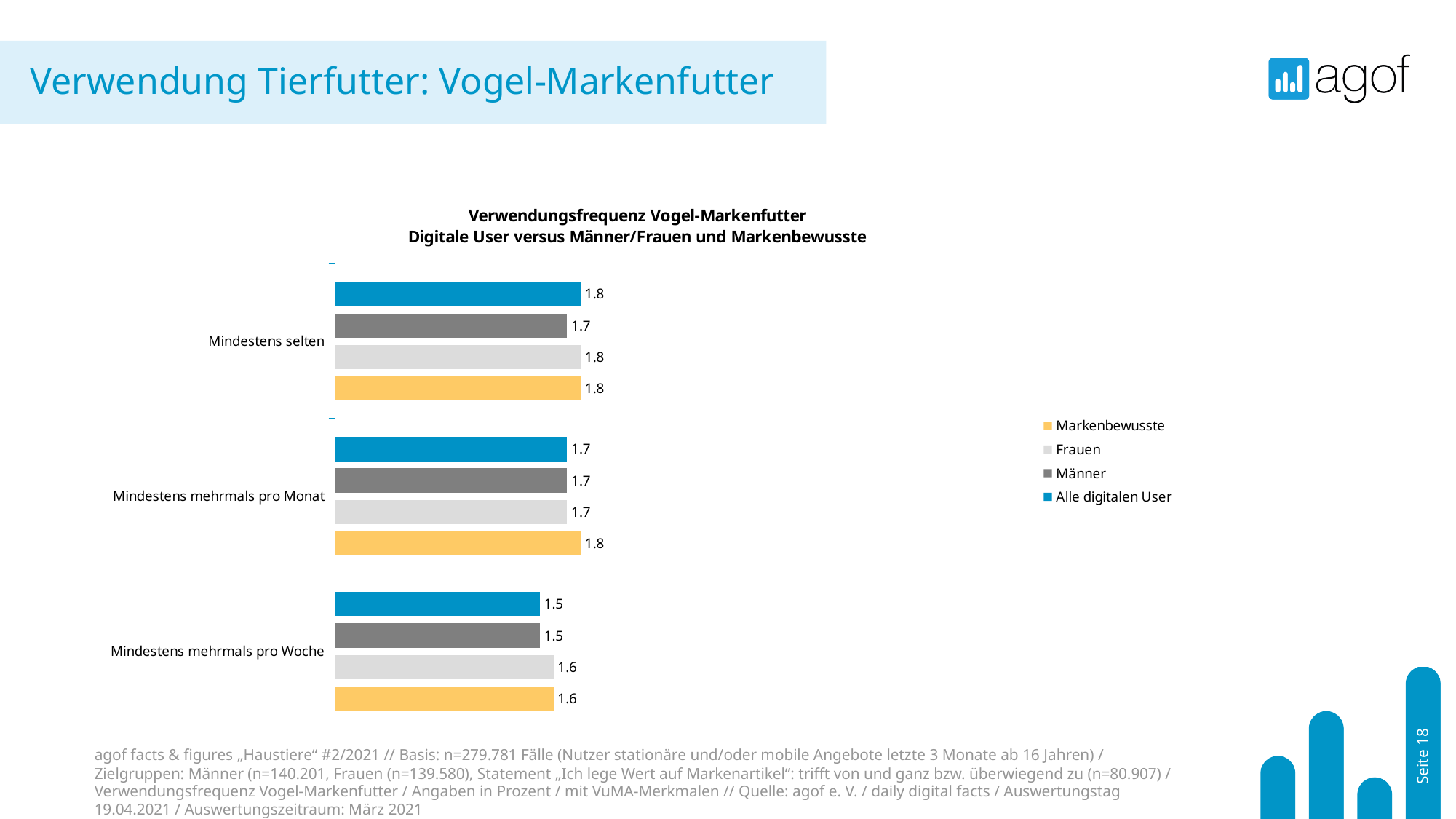
What is the value for Markenbewusste in the category Mindestens mehrmals pro Monat? 1.8 What is the difference between the Alle digitalen User values for Mindestens selten and Mindestens mehrmals pro Woche? 0.3 What is the value for Alle digitalen User in the category Mindestens selten? 1.8 What is the value for Männer in the category Mindestens mehrmals pro Woche? 1.5 Which series is shown in yellow in the legend? Markenbewusste How many series does the legend list? 4 What is the value for Frauen in the category Mindestens mehrmals pro Woche? 1.6 Which is larger in the category Mindestens selten: the value for Männer or the value for Markenbewusste? Markenbewusste In which category is the value for Alle digitalen User lowest? Mindestens mehrmals pro Woche How many categories are shown on the vertical axis? 3 What kind of chart is shown on the slide? bar chart What is the first line of the chart title? Verwendungsfrequenz Vogel-Markenfutter